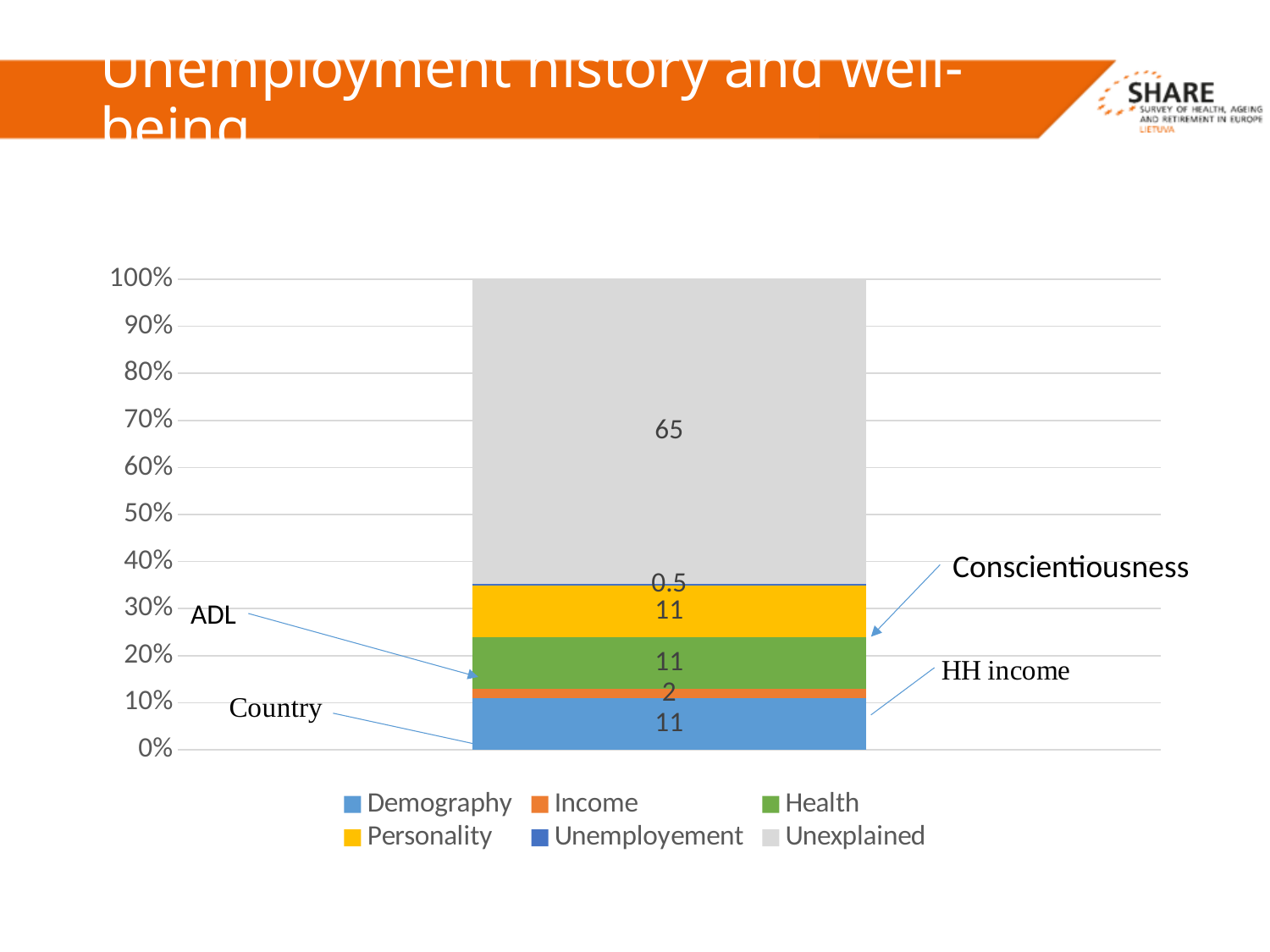
What is the value of the Unemployement segment? 0.5 Which series is shown in grey in the legend? Unexplained Which series has the largest segment in the bar? Unexplained What is the value of the Health segment? 11 What is the difference between the Unexplained value and the Personality value? 54 Which is larger, the Income segment or the Demography segment? Demography Which series has the smallest segment in the bar? Unemployement What is the value of the Unexplained segment? 65 How many series does the legend list? 6 What is the value of the Income segment? 2 How many bars are plotted in the chart? 1 What kind of chart is shown on the slide? stacked bar chart